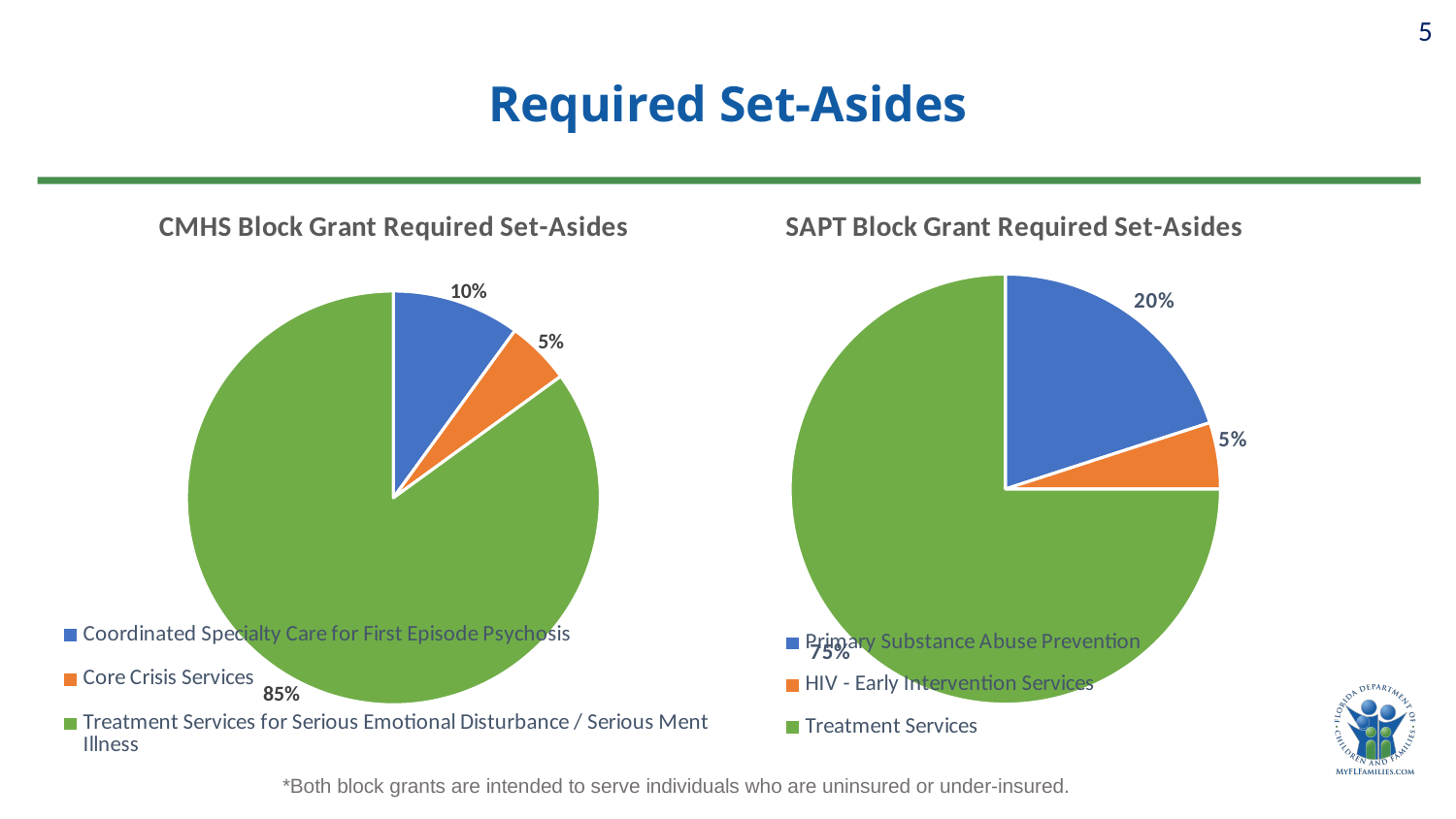
How many categories does the SAPT Block Grant Required Set-Asides chart show? 3 In the SAPT Block Grant Required Set-Asides chart, what share is Treatment Services? 75% In the CMHS Block Grant Required Set-Asides chart, what share is Coordinated Specialty Care for First Episode Psychosis? 10% In the SAPT Block Grant Required Set-Asides chart, what share is Primary Substance Abuse Prevention? 20% In the SAPT Block Grant Required Set-Asides chart, which category has the smallest share? HIV - Early Intervention Services In the SAPT Block Grant Required Set-Asides chart, what is the difference between the Primary Substance Abuse Prevention share and the HIV - Early Intervention Services share? 15% In the CMHS Block Grant Required Set-Asides chart, which category has the largest share? Treatment Services for Serious Emotional Disturbance / Serious Mental Illness Which is larger: the Coordinated Specialty Care for First Episode Psychosis share in the CMHS chart or the Primary Substance Abuse Prevention share in the SAPT chart? Primary Substance Abuse Prevention In the CMHS Block Grant Required Set-Asides chart, what share is Treatment Services for Serious Emotional Disturbance / Serious Mental Illness? 85% In the CMHS Block Grant Required Set-Asides chart, what share is Core Crisis Services? 5% What type of chart is the CMHS Block Grant Required Set-Asides chart? Pie chart In the SAPT Block Grant Required Set-Asides chart, what share is HIV - Early Intervention Services? 5%